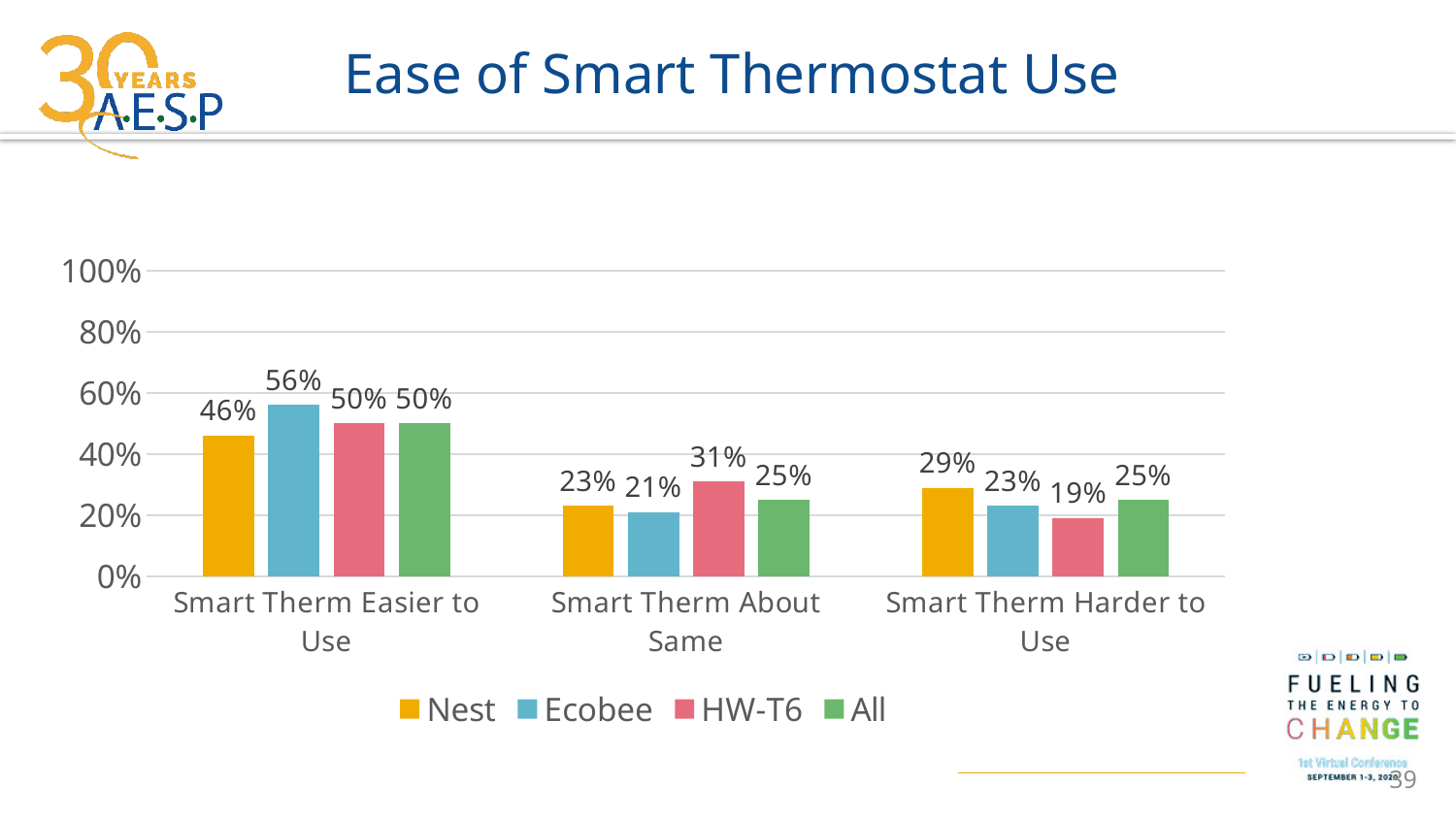
Which series has the highest value in the 'Smart Therm Easier to Use' category? Ecobee What is the value for Nest in the 'Smart Therm Harder to Use' category? 29% What is the value for HW-T6 in the 'Smart Therm About Same' category? 31% Is the value for All in the 'Smart Therm Easier to Use' category greater or less than 40%? greater How many series does the legend list? 4 What is the value for Ecobee in the 'Smart Therm Easier to Use' category? 56% Which series has the lowest value in the 'Smart Therm Harder to Use' category? HW-T6 What is the title of the chart? Ease of Smart Thermostat Use What is the difference between the Ecobee and Nest values in the 'Smart Therm Easier to Use' category? 10% What kind of chart is shown on the slide? Bar chart Which is larger: the HW-T6 value for 'Smart Therm About Same' or the HW-T6 value for 'Smart Therm Harder to Use'? Smart Therm About Same How many categories are shown on the x axis? 3